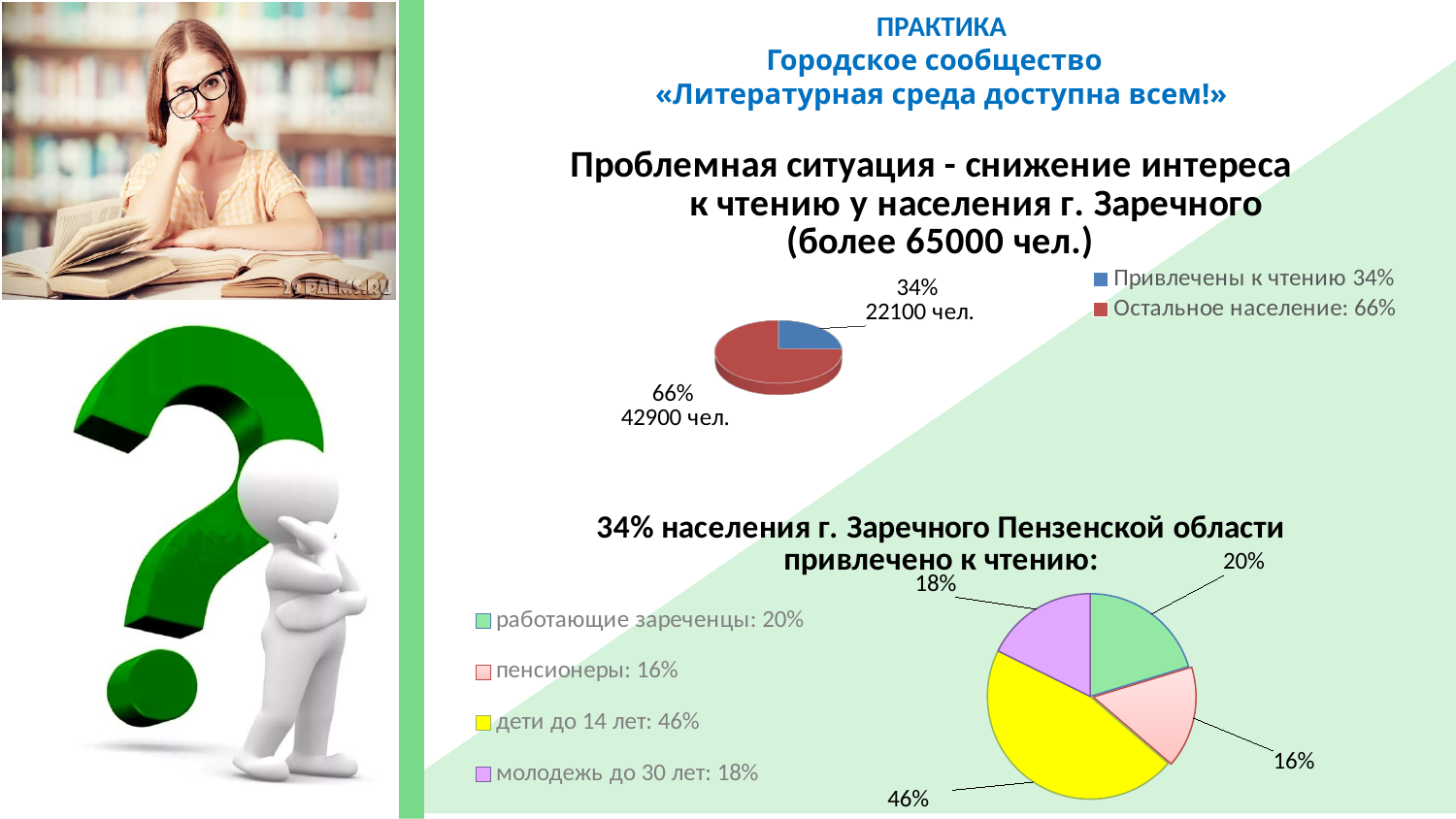
In the top pie chart, what share of the population is labelled as attracted to reading (Привлечены к чтению)? 34% In the bottom pie chart, what is the difference between the shares of 'дети до 14 лет' and 'работающие зареченцы'? 26% In the bottom pie chart, which category has the smallest share? пенсионеры In the bottom pie chart, which category has the largest share? дети до 14 лет In the bottom pie chart, what share is labelled for 'пенсионеры'? 16% How many series does the legend of the top pie chart list? 2 In the bottom pie chart, what colour is the slice for 'молодежь до 30 лет'? Purple In the top pie chart, how many people does the 34% slice represent? 22100 чел. What type of chart is the top chart on the slide? Pie chart In the bottom pie chart, what share is labelled for 'дети до 14 лет'? 46% How many categories does the bottom pie chart show? 4 In the top pie chart, how many people does the 'Остальное население' slice represent? 42900 чел.